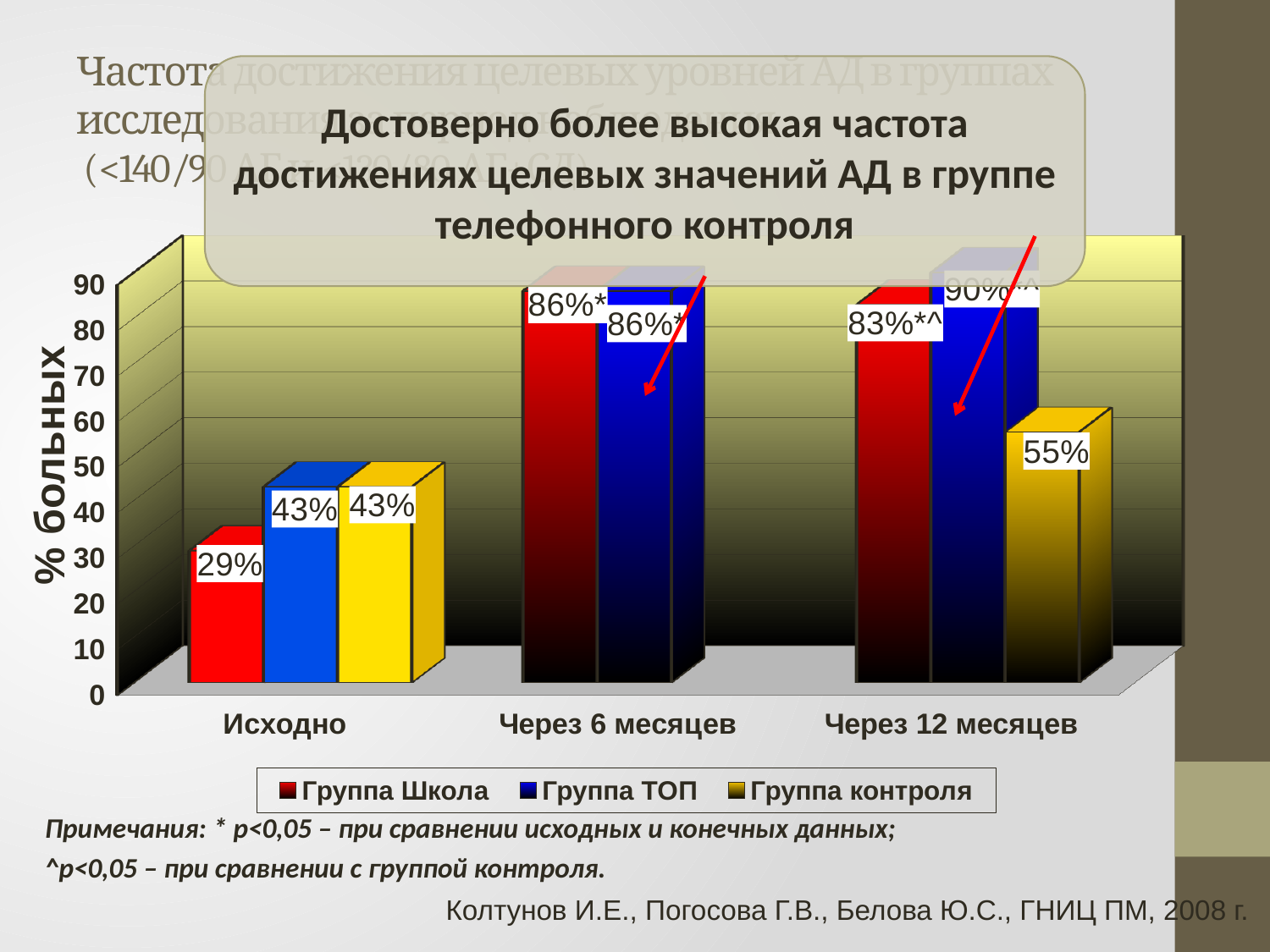
How many series does the legend list? 3 What kind of chart is shown on the slide? Bar chart What is the value for Группа Школа at Через 12 месяцев? 83% What is the value for Группа ТОП at Исходно? 43% Which group has the lowest value at Исходно? Группа Школа Which group has the highest value at Через 12 месяцев? Группа ТОП At Через 12 месяцев, which is larger: Группа ТОП or Группа контроля? Группа ТОП What is the value for Группа Школа at Исходно? 29% What is the value for Группа Школа at Через 6 месяцев? 86% What is the difference between Группа ТОП and Группа Школа at Исходно? 14 percentage points How many categories are shown on the x axis? 3 What is the value for Группа контроля at Через 12 месяцев? 55%